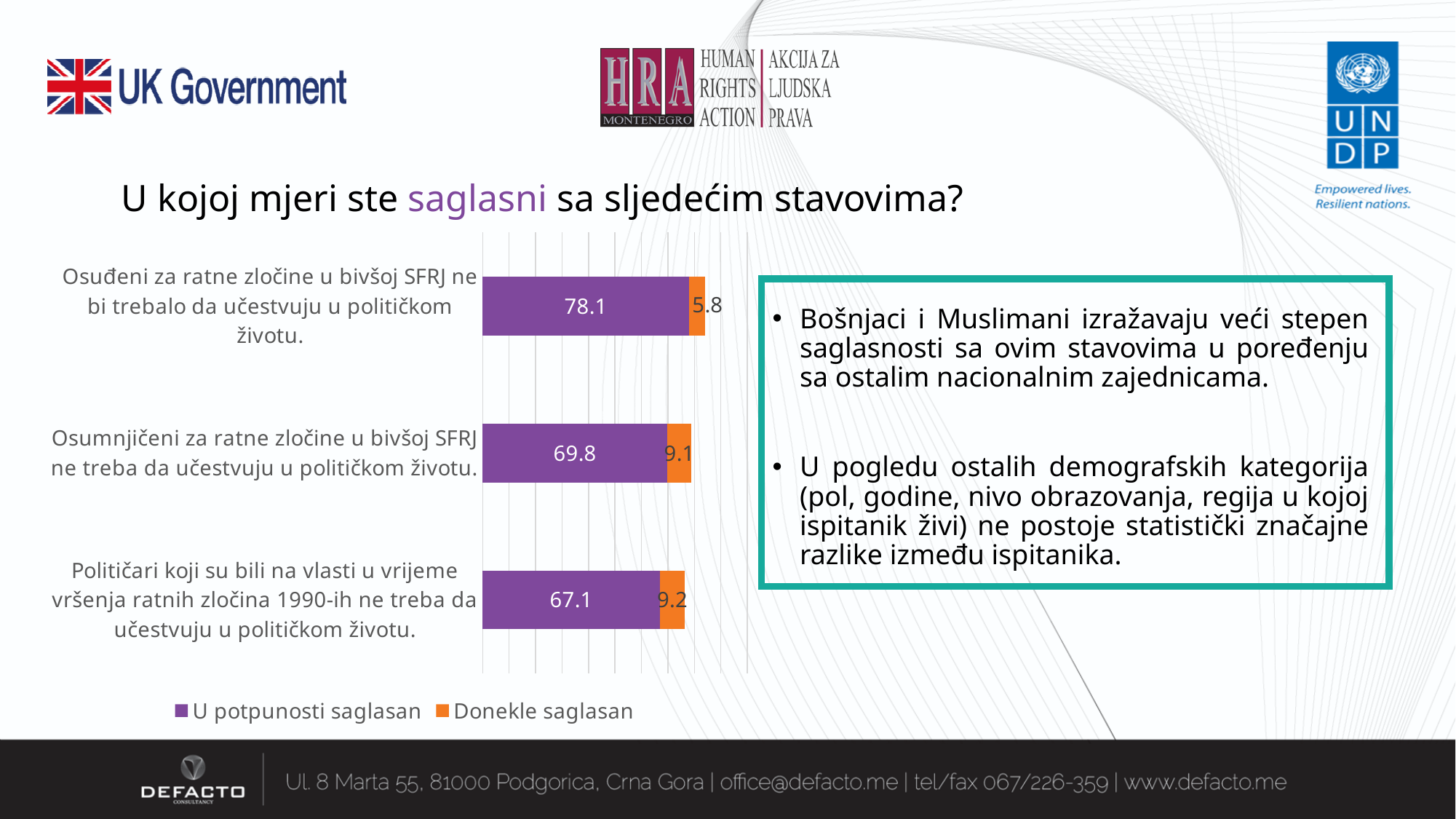
What is the 'Donekle saglasan' value for the statement 'Osumnjičeni za ratne zločine u bivšoj SFRJ ne treba da učestvuju u političkom životu.'? 9.1 How many statements (categories) are shown in the chart? 3 What is the 'Donekle saglasan' value for the statement 'Osuđeni za ratne zločine u bivšoj SFRJ ne bi trebalo da učestvuju u političkom životu.'? 5.8 What kind of chart is shown on the slide? Stacked bar chart What is the 'U potpunosti saglasan' value for the statement about 'Političari koji su bili na vlasti u vrijeme vršenja ratnih zločina 1990-ih'? 67.1 Which statement has the lowest 'U potpunosti saglasan' value? Političari koji su bili na vlasti u vrijeme vršenja ratnih zločina 1990-ih ne treba da učestvuju u političkom životu. What is the difference between the 'U potpunosti saglasan' values for the 'Osuđeni' statement and the 'Osumnjičeni' statement? 8.3 Which statement has the highest 'U potpunosti saglasan' value? Osuđeni za ratne zločine u bivšoj SFRJ ne bi trebalo da učestvuju u političkom životu. What is the 'U potpunosti saglasan' value for the statement 'Osuđeni za ratne zločine u bivšoj SFRJ ne bi trebalo da učestvuju u političkom životu.'? 78.1 Which statement has the lowest 'Donekle saglasan' value? Osuđeni za ratne zločine u bivšoj SFRJ ne bi trebalo da učestvuju u političkom životu. What is the total of the stacked bar for the statement 'Osumnjičeni za ratne zločine u bivšoj SFRJ ne treba da učestvuju u političkom životu.'? 78.9 How many series does the chart legend list? 2